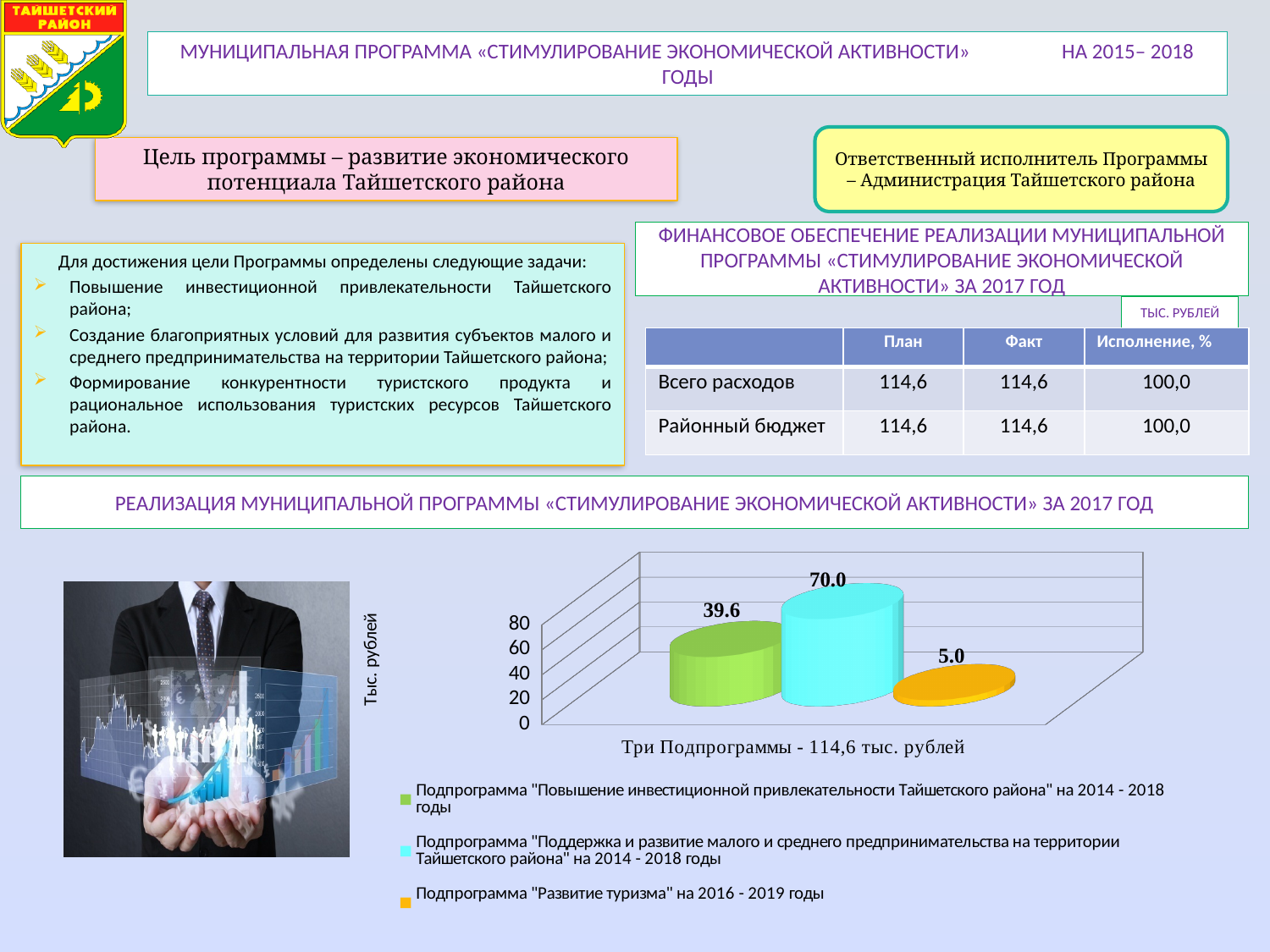
Which is larger: the value for the investment attractiveness subprogram or the tourism subprogram? the investment attractiveness subprogram Which subprogram has the highest value in the chart? Подпрограмма "Поддержка и развитие малого и среднего предпринимательства на территории Тайшетского района" How many series does the chart legend list? 3 What colour is the bar for the subprogram "Развитие туризма"? orange What is the total of the three subprogram values shown in the chart? 114.6 What is the value for the subprogram "Развитие туризма"? 5.0 Which subprogram has the lowest value in the chart? Подпрограмма "Развитие туризма" What is the value for the subprogram "Поддержка и развитие малого и среднего предпринимательства на территории Тайшетского района"? 70.0 What type of chart is shown at the bottom of the slide? bar chart What is the difference between the values for the small and medium business subprogram and the investment attractiveness subprogram? 30.4 What is the value for the subprogram "Повышение инвестиционной привлекательности Тайшетского района"? 39.6 What unit is shown on the vertical axis of the chart? Тыс. рублей